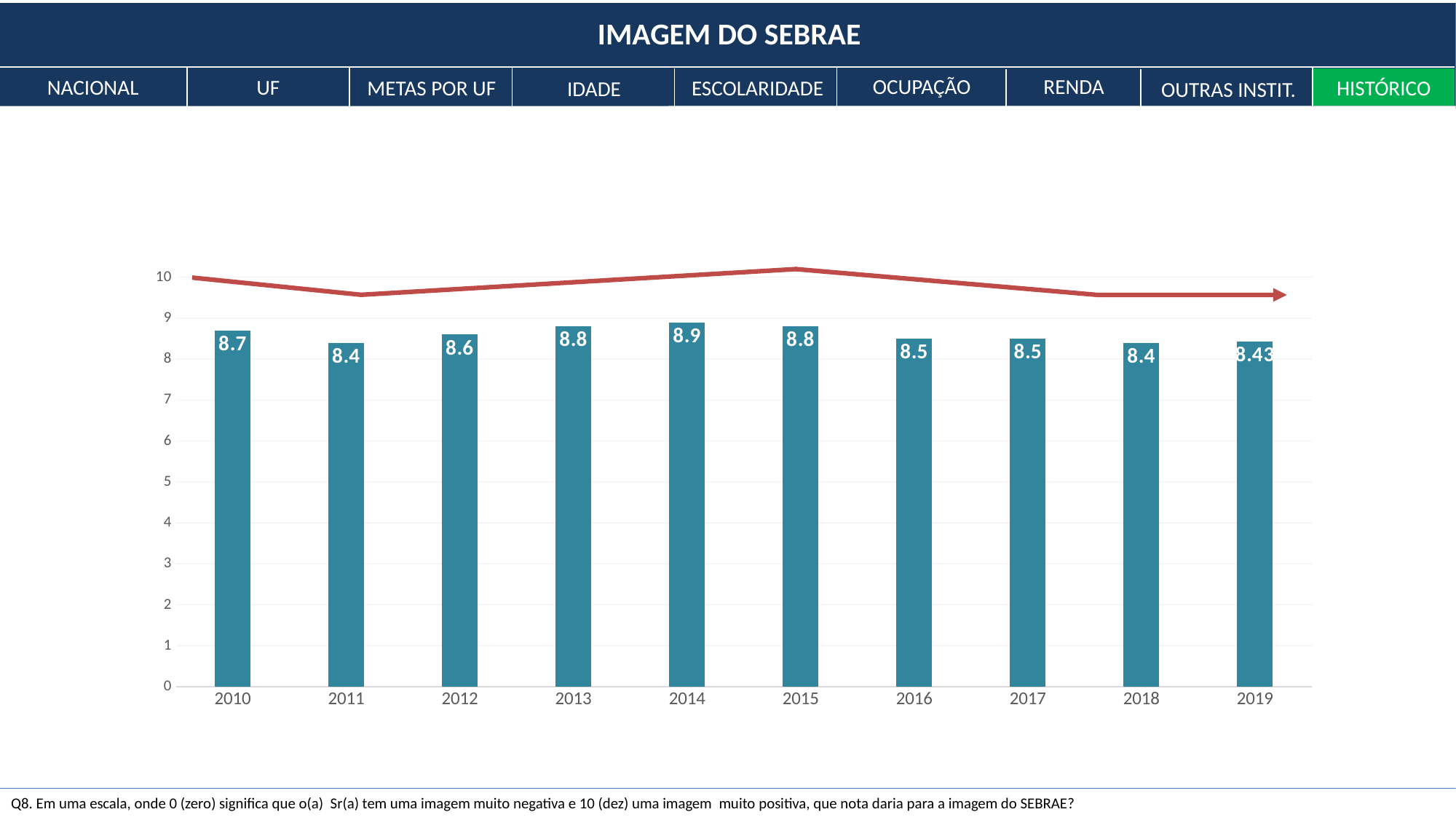
What is the value for 2019? 8.43 What kind of chart is shown on the slide? bar chart What is the difference between the values for 2010 and 2018? 0.3 Do the bar values rise or fall from 2015 to 2018? fall What is the value for 2014? 8.9 Is the value for 2012 greater or less than 8? greater What is the title shown at the top of the slide? IMAGEM DO SEBRAE How many years are shown on the x axis? 10 What is the value for 2010? 8.7 Which year has the highest value? 2014 What is the difference between the values for 2014 and 2011? 0.5 Which is larger, the value for 2013 or the value for 2016? 2013